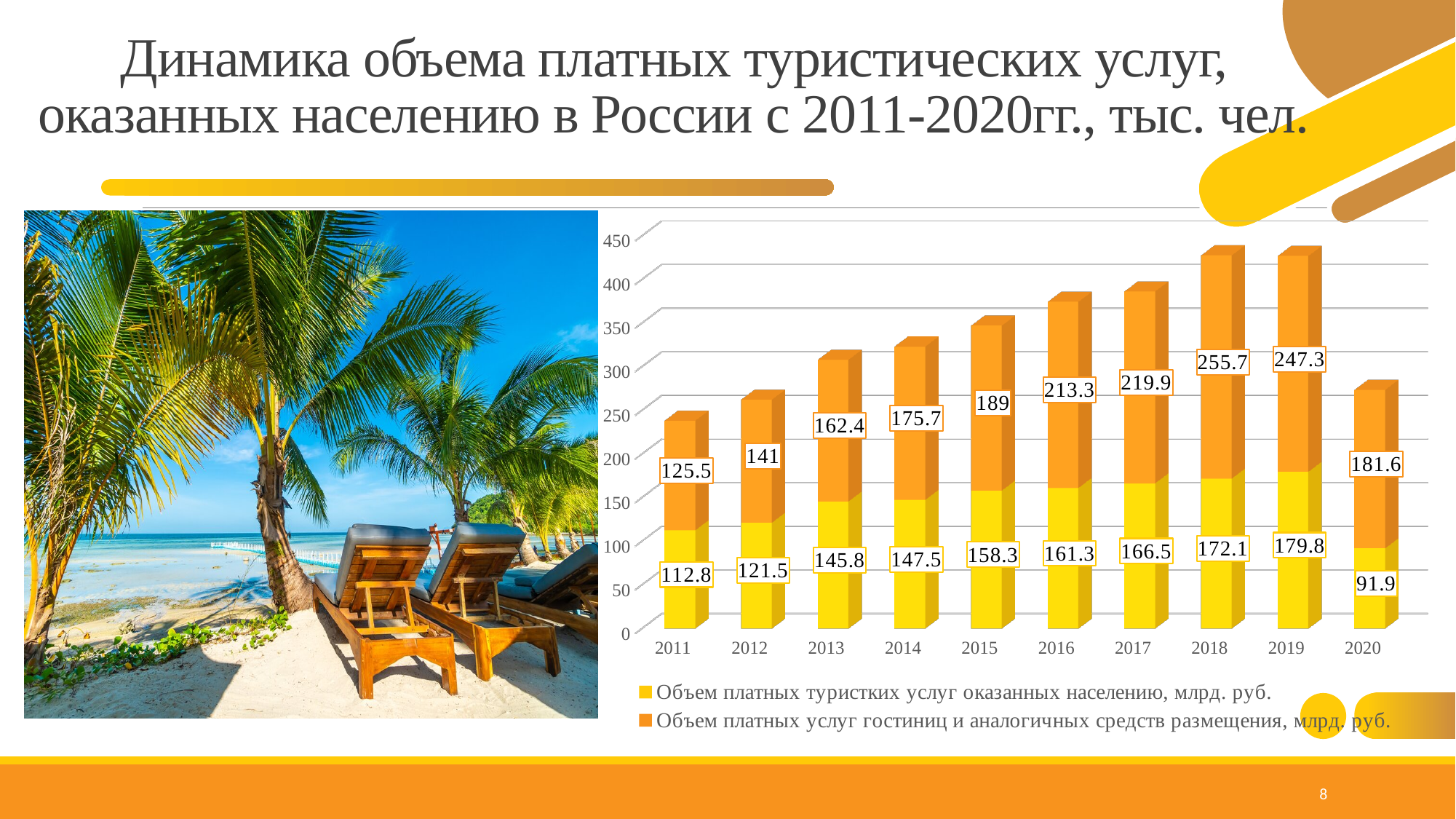
How many series does the legend list? 2 What is the value of the yellow series (Объем платных туристких услуг оказанных населению) for 2015? 158.3 How many years are shown on the x axis? 10 What is the value of the yellow series for 2020? 91.9 Which year has the highest value for the orange series (hotel services)? 2018 What kind of chart is shown on the slide? Stacked bar chart What is the total of the stacked bar for 2011? 238.3 Which is larger: the yellow series value for 2013 or for 2014? 2014 Which year has the lowest value for the yellow series (tourist services)? 2020 What is the total of the stacked bar for 2020? 273.5 What is the value of the orange series (Объем платных услуг гостиниц и аналогичных средств размещения) for 2018? 255.7 What is the difference between the orange series values for 2018 and 2019? 8.4